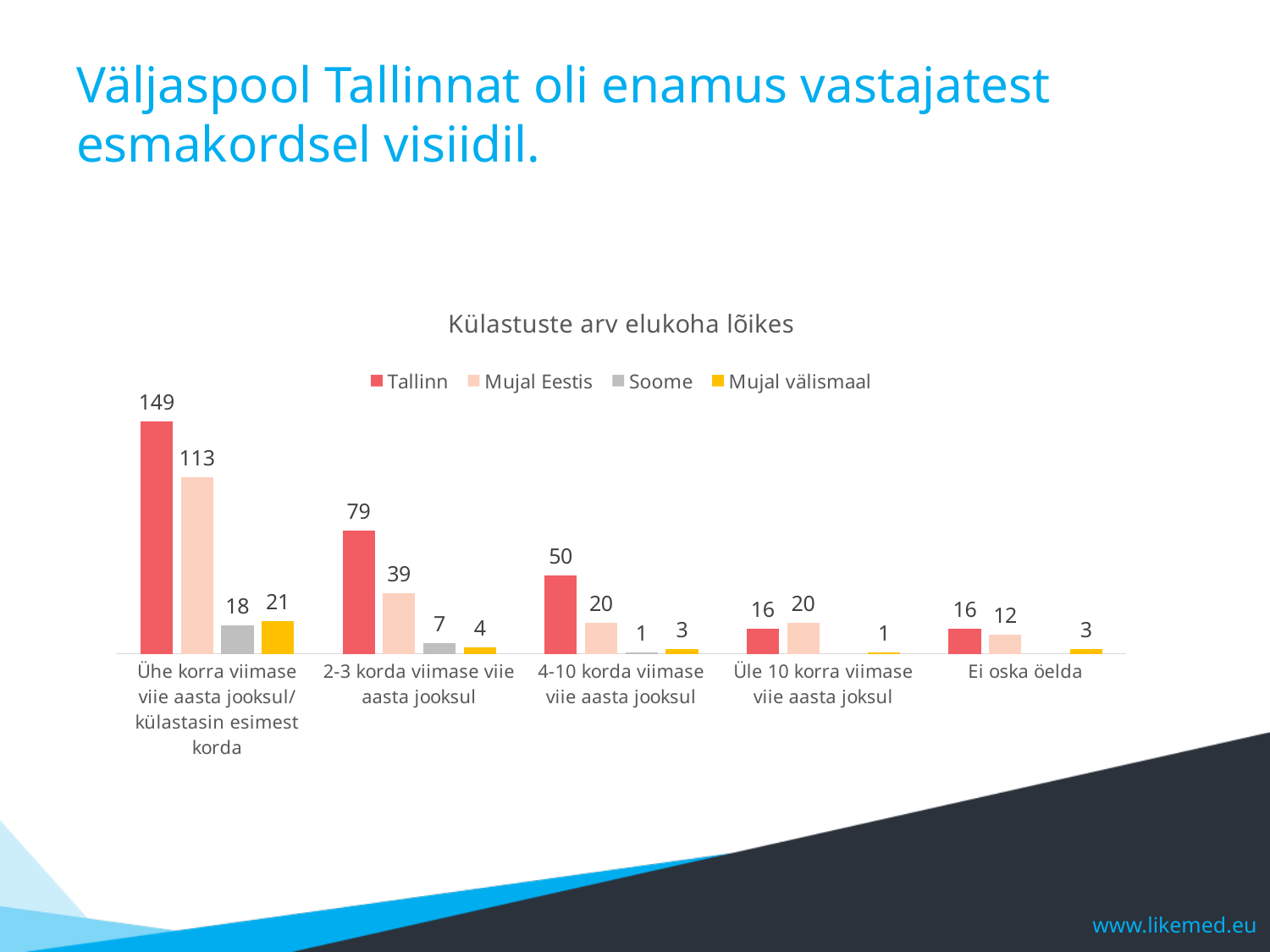
What is the value for Mujal Eestis in the category "2-3 korda viimase viie aasta jooksul"? 39 How many series does the legend list? 4 What is the value for Tallinn in the category "Ühe korra viimase viie aasta jooksul/ külastasin esimest korda"? 149 What is the title of the chart? Külastuste arv elukoha lõikes Which category has the lowest value for Mujal Eestis? Ei oska öelda In the category "Üle 10 korra viimase viie aasta joksul", which is larger: Tallinn or Mujal Eestis? Mujal Eestis How many categories are shown on the x axis? 5 What is the value for Soome in the category "Ühe korra viimase viie aasta jooksul/ külastasin esimest korda"? 18 What kind of chart is shown on the slide? Bar chart Which category has the highest value for Tallinn? Ühe korra viimase viie aasta jooksul/ külastasin esimest korda What is the value for Mujal välismaal in the category "Ei oska öelda"? 3 What is the difference between the Tallinn and Mujal Eestis values in the category "Ühe korra viimase viie aasta jooksul/ külastasin esimest korda"? 36